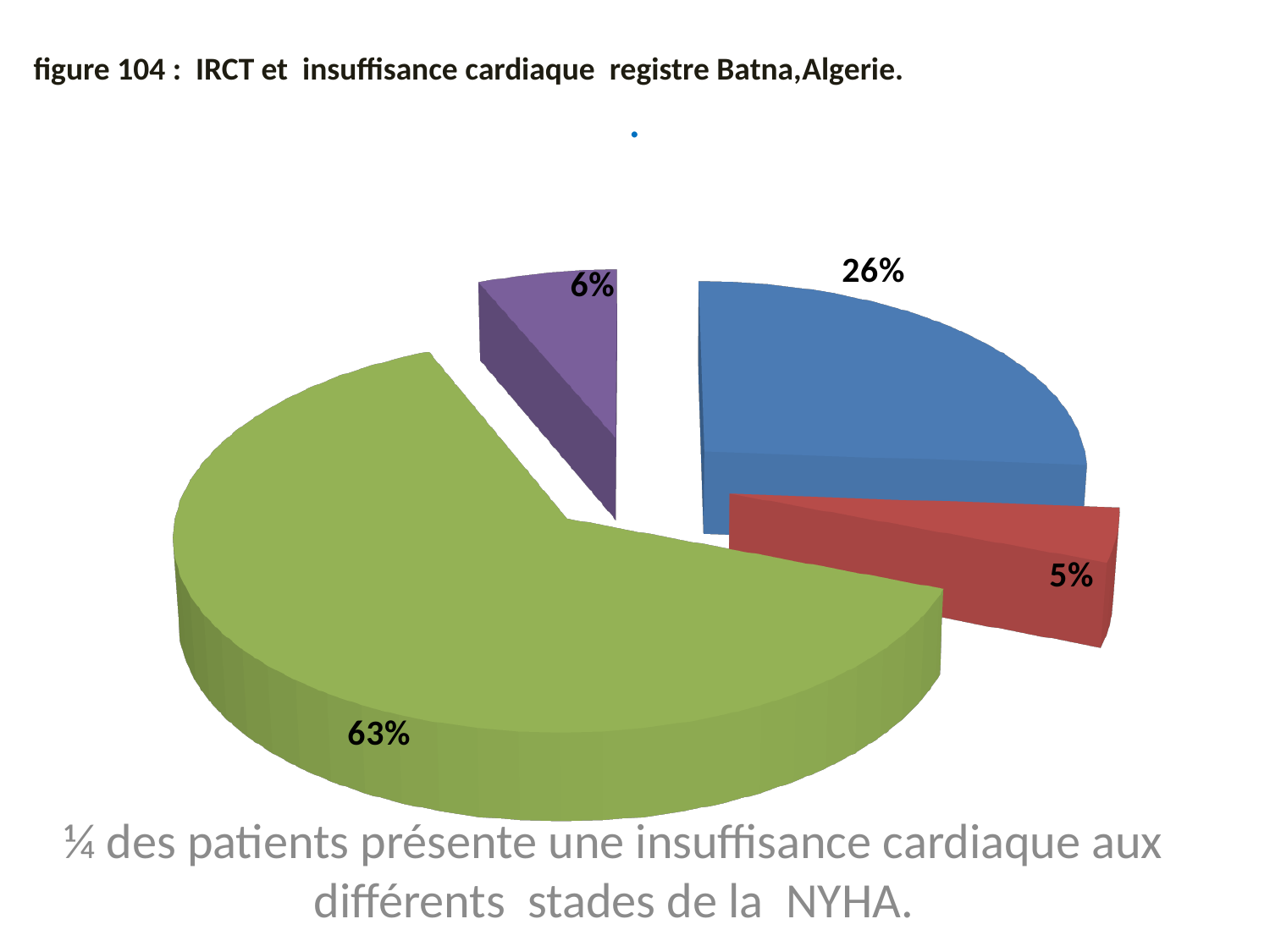
What percentage is shown on the red slice of the pie chart? 5% What percentage is shown on the purple slice of the pie chart? 6% Which colour slice represents the smallest share of the pie chart? red What percentage is shown on the green slice of the pie chart? 63% Which is larger, the purple slice or the red slice? purple What is the combined percentage of the blue, red and purple slices? 37% How many slices does the pie chart have? 4 What is the difference in percentage points between the green slice and the blue slice? 37 What percentage is shown on the blue slice of the pie chart? 26% What kind of chart is shown on the slide? pie chart What is the figure number given in the title of the chart? figure 104 Which colour slice represents the largest share of the pie chart? green